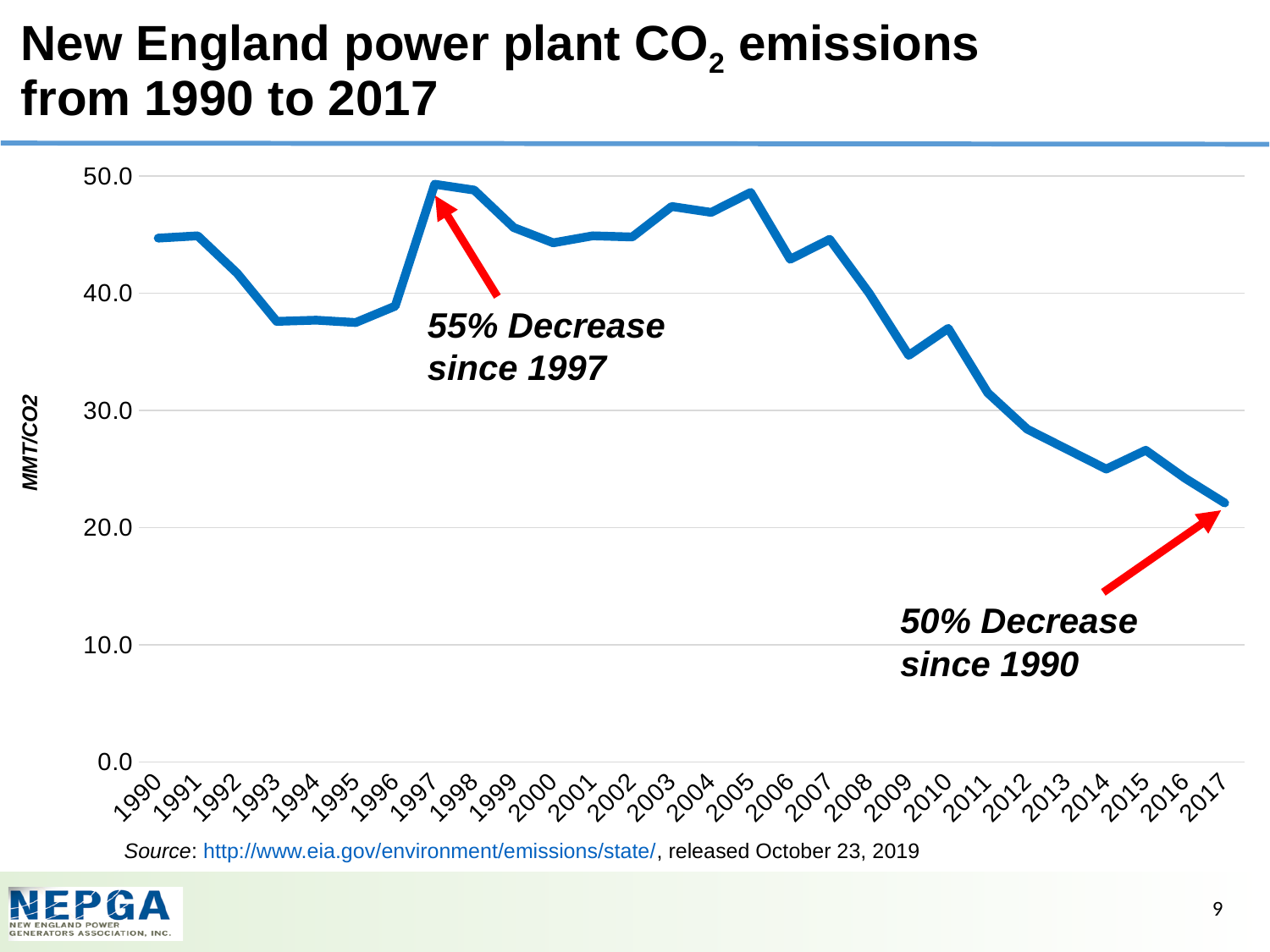
Is the value for 2005 greater or less than 40.0? greater Is the value for 1997 greater or less than 40.0? greater Is the value for 2013 greater or less than 30.0? less According to the annotation on the chart, by what percentage have emissions decreased since 1997? 55% Do the emissions values generally rise or fall from 2005 to 2017? fall Which year has the lowest CO2 emissions value on the chart? 2017 How many years are plotted along the x axis? 28 What kind of chart is shown on the slide? line chart Which year has the larger emissions value, 1990 or 2017? 1990 What unit label is shown on the y axis? MMT/CO2